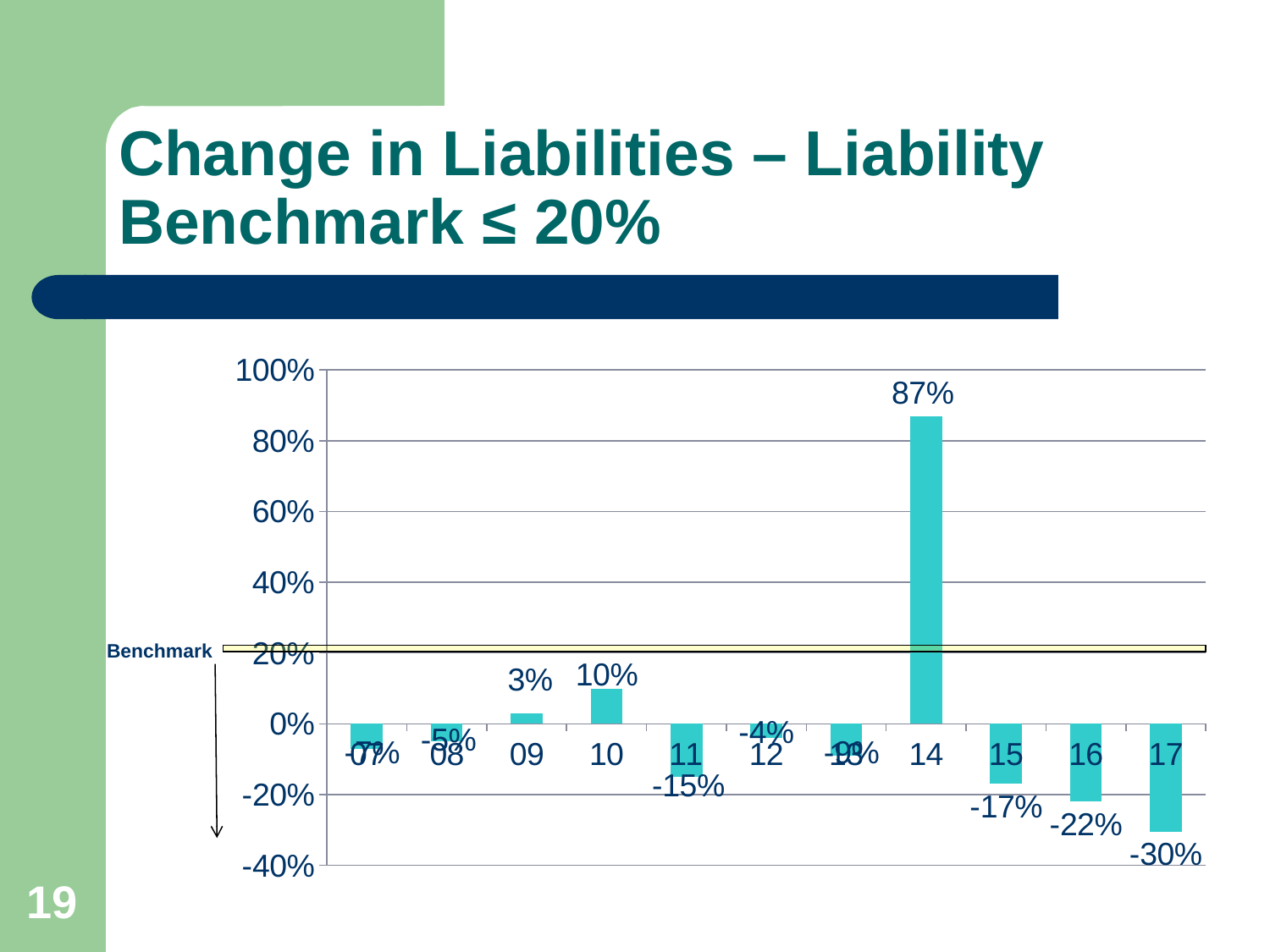
What is the difference between the values for 10 and 09? 7% What is the value for 10? 10% What is the value for 17? -30% How many years are shown on the x axis? 11 Which is larger, the value for 15 or the value for 16? 15 Which year has the lowest value? 17 At what level is the Benchmark line drawn? 20% What is the value for 14? 87% What is the value for 11? -15% Which year has the highest value? 14 Is the value for 14 greater or less than 80%? greater What is the value for 16? -22%